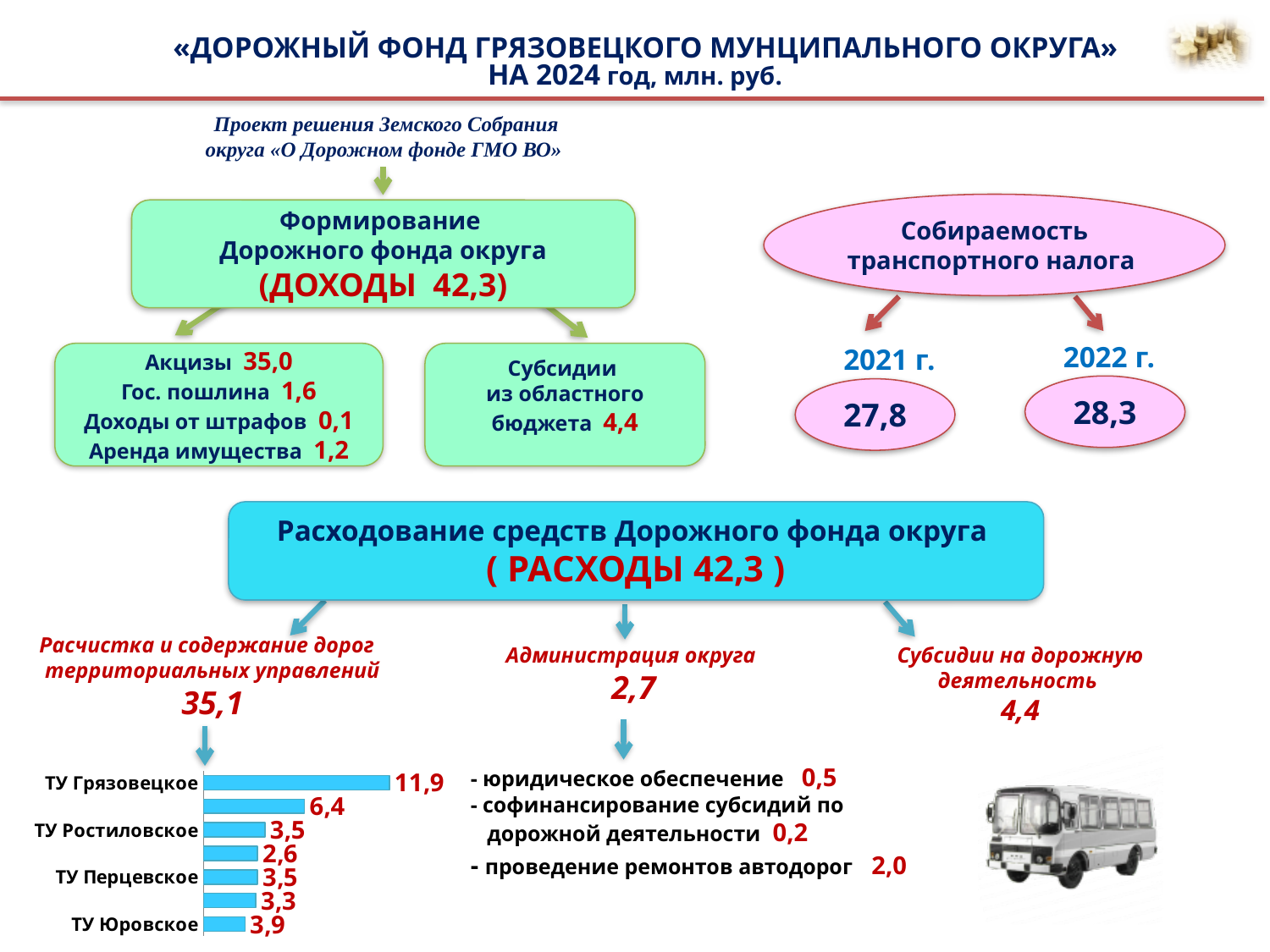
In the bar chart, what is the value for ТУ Ростиловское? 3,5 In the bar chart, what is the value for ТУ Грязовецкое? 11,9 What kind of chart is shown at the bottom left of the slide? bar chart Which labelled category has the highest value in the bar chart? ТУ Грязовецкое In the bar chart, what is the value for ТУ Юровское? 3,9 What is the difference between the values for ТУ Грязовецкое and ТУ Юровское in the bar chart? 8,0 What is the smallest value shown on any bar in the bar chart? 2,6 In the bar chart, which is larger: the value for ТУ Грязовецкое or the value for ТУ Юровское? ТУ Грязовецкое How many bars are there in the bar chart? 7 In the bar chart, what is the value for ТУ Перцевское? 3,5 What colour are the bars in the bar chart? blue What is the sum of all the bar values in the bar chart? 35,1